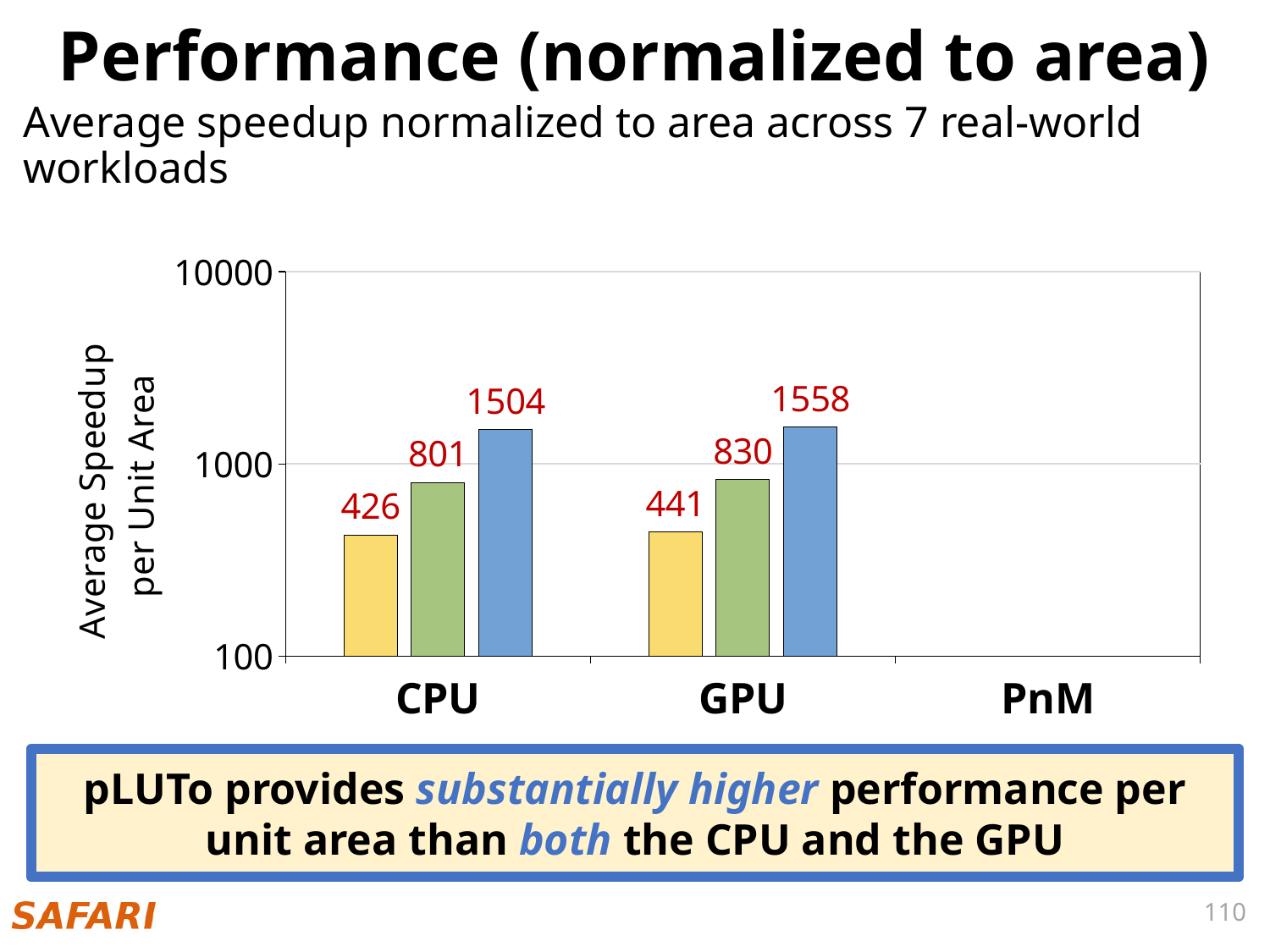
What type of chart is shown on the slide? Bar chart How many categories are labelled on the x axis? 3 What is the value of the green bar for CPU? 801 What is the difference between the blue bar for GPU and the blue bar for CPU? 54 Which bar has the highest value on the chart? The blue bar for GPU (1558) Which is larger, the yellow bar for CPU or the yellow bar for GPU? The yellow bar for GPU What is the value of the yellow bar for CPU? 426 What is the value of the green bar for GPU? 830 Is the value of the blue bar for CPU greater or less than 1000? greater What is the value of the blue bar for GPU? 1558 What is the difference between the green bar and the yellow bar for CPU? 375 Which bar has the lowest value on the chart? The yellow bar for CPU (426)